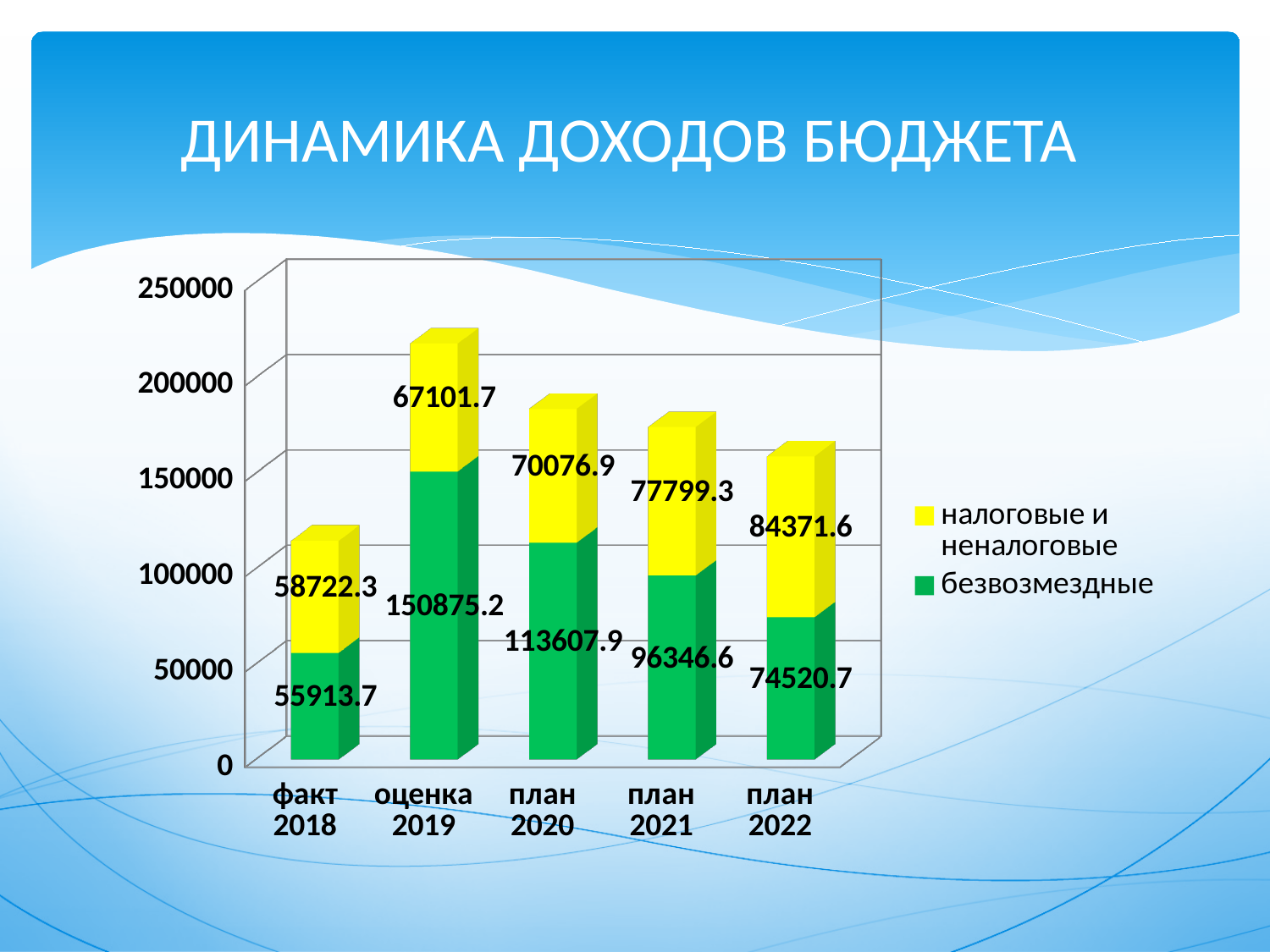
Which category has the highest value for безвозмездные? оценка 2019 What is the value of налоговые и неналоговые for план 2022? 84371.6 Is the total of the stacked bar for оценка 2019 greater or less than 200000? greater Do the values for налоговые и неналоговые rise or fall from факт 2018 to план 2022? rise Which is larger: безвозмездные for план 2021 or налоговые и неналоговые for план 2021? безвозмездные for план 2021 What is the value of безвозмездные for факт 2018? 55913.7 What is the difference between безвозмездные for оценка 2019 and факт 2018? 94961.5 How many categories are shown on the x axis? 5 What is the total of the stacked bar for план 2020? 183684.8 How many series does the legend list? 2 What is the value of безвозмездные for оценка 2019? 150875.2 Which category has the lowest value for налоговые и неналоговые? факт 2018